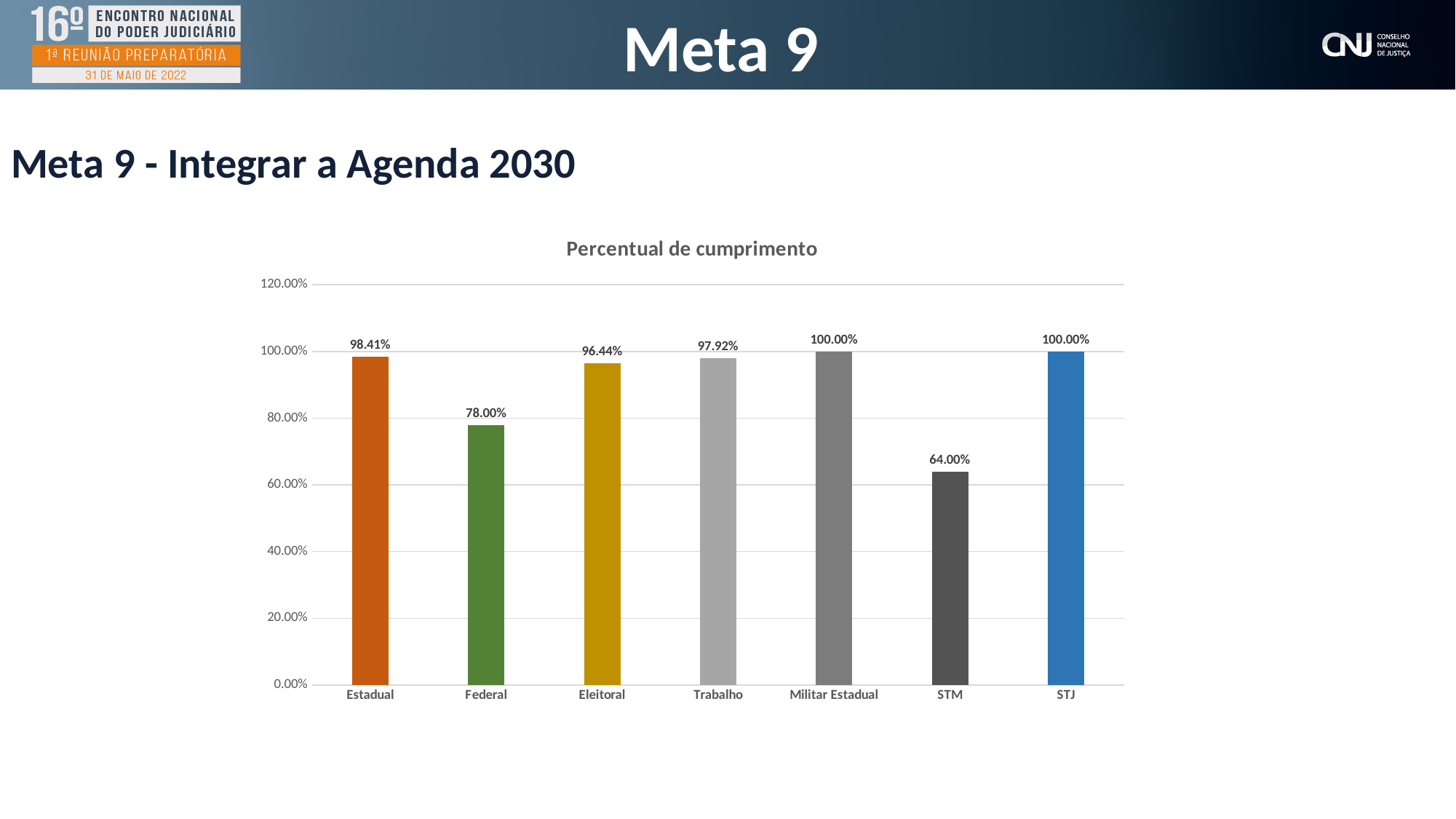
Which category has the lowest value? STM What is the value for Estadual? 98.41% What is the value for STM? 64.00% What kind of chart is shown? bar chart What is the value for Trabalho? 97.92% What is the title of the chart? Percentual de cumprimento Which is larger, the value for Eleitoral or the value for STM? Eleitoral How many categories are shown on the x axis? 7 What is the value for Federal? 78.00% Which categories share the highest value of 100.00%? Militar Estadual and STJ What is the difference between the values for Estadual and Federal? 20.41% Is the value for Federal greater or less than 80.00%? less